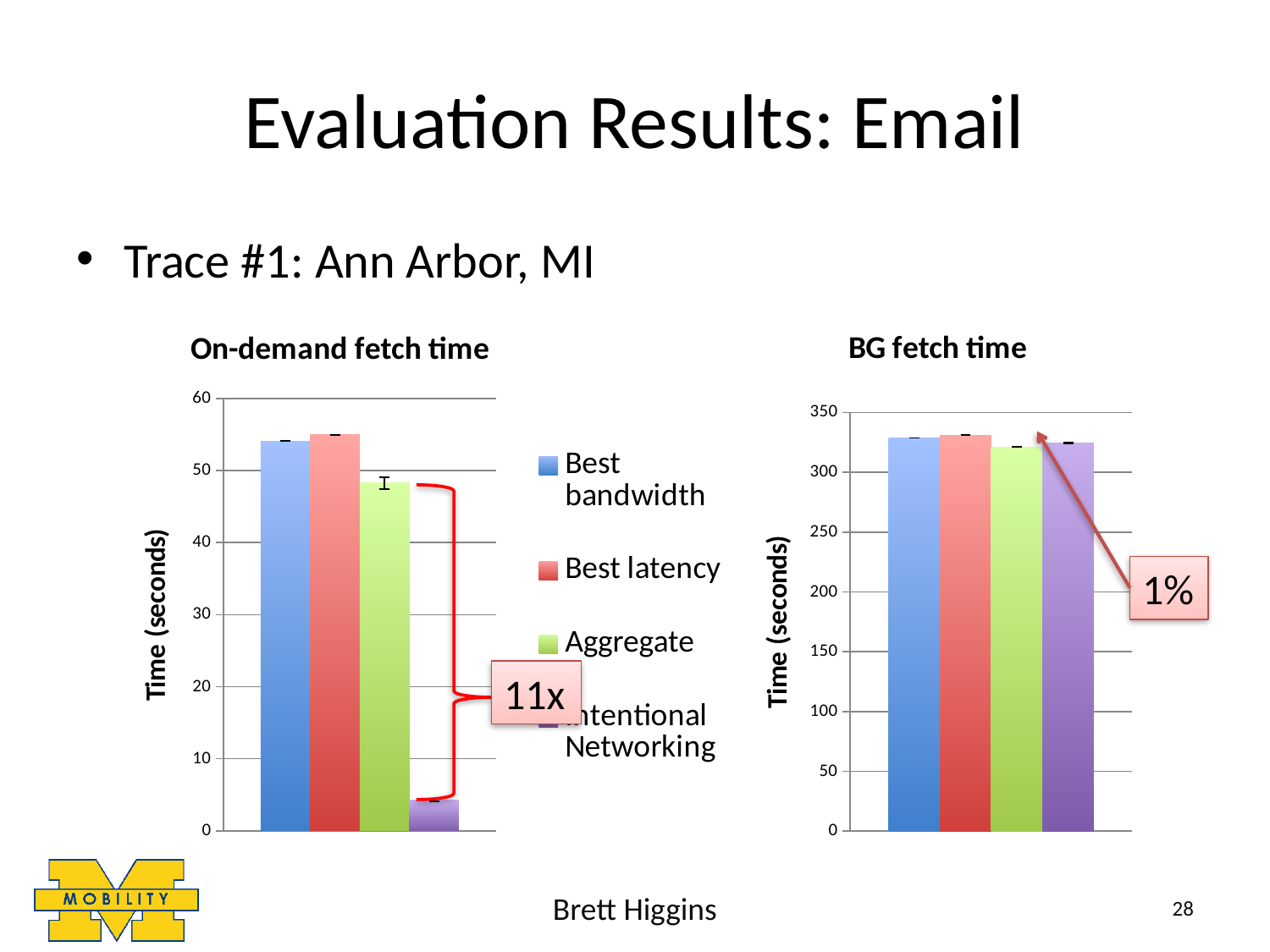
What factor is shown in the callout on the "On-demand fetch time" chart? 11x In the "BG fetch time" chart, is the value for Best latency greater or less than 300? greater In the "BG fetch time" chart, is the value for Intentional Networking greater or less than 350? less In the "On-demand fetch time" chart, which series has the lowest value? Intentional Networking In the "On-demand fetch time" chart, is the value for Best bandwidth greater or less than 50? greater What is the y-axis label of the "BG fetch time" chart? Time (seconds) How many bars are plotted in the "BG fetch time" chart? 4 What kind of chart is the "On-demand fetch time" chart? bar chart In the "On-demand fetch time" chart, which is larger, Aggregate or Intentional Networking? Aggregate How many series does the legend list for the "On-demand fetch time" chart? 4